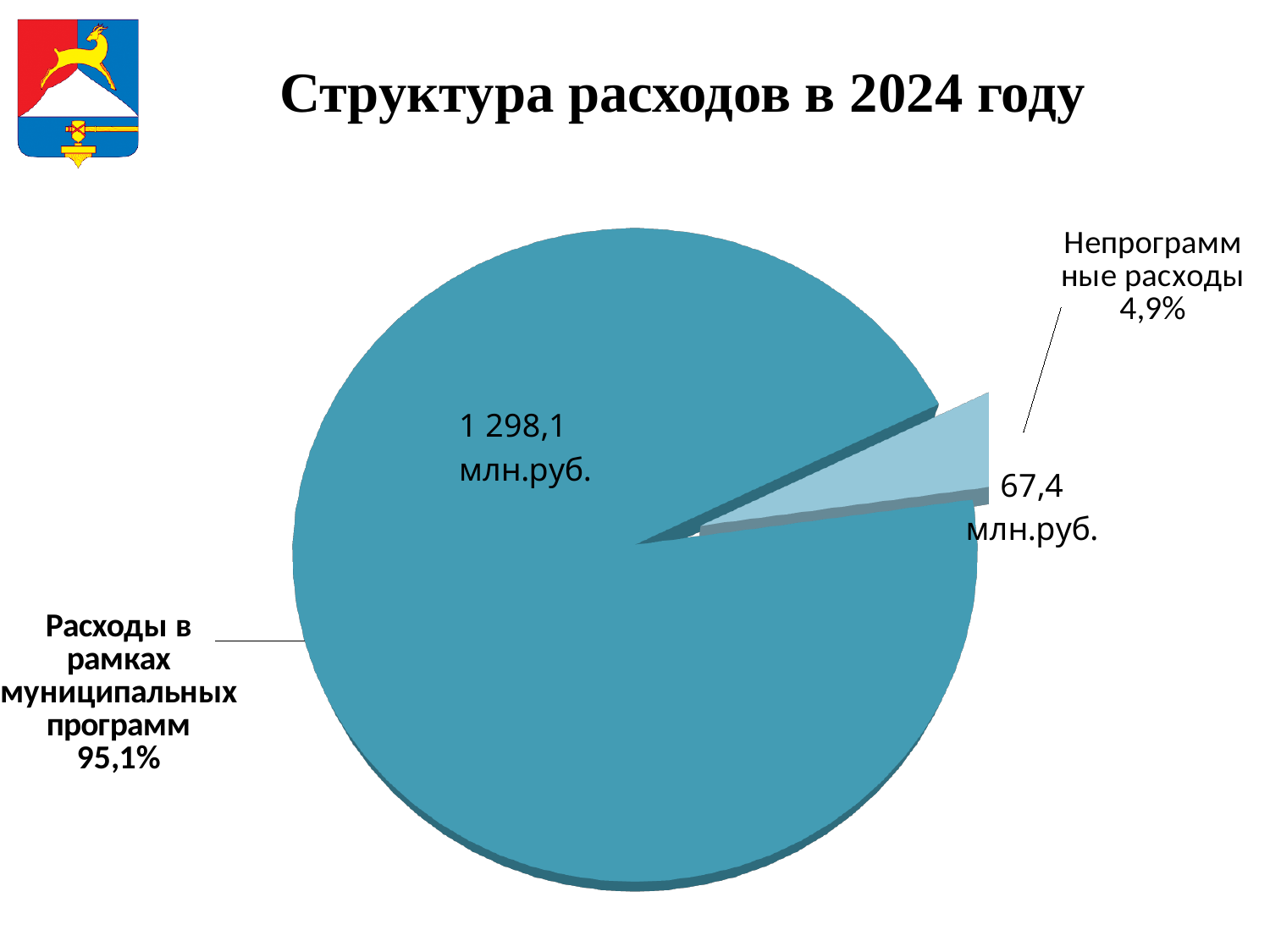
How many slices does the pie chart have? 2 What share of the pie does 'Расходы в рамках муниципальных программ' take? 95,1% What is the value shown for the slice 'Непрограммные расходы'? 67,4 млн.руб. Which slice of the pie is the largest? Расходы в рамках муниципальных программ Which is larger: 'Расходы в рамках муниципальных программ' or 'Непрограммные расходы'? Расходы в рамках муниципальных программ What is the title of the chart on the slide? Структура расходов в 2024 году What kind of chart is shown on the slide? Pie chart What is the difference in млн.руб. between 'Расходы в рамках муниципальных программ' and 'Непрограммные расходы'? 1 230,7 млн.руб. What share of the pie does 'Непрограммные расходы' take? 4,9% Which slice of the pie is the smallest? Непрограммные расходы What is the total of the two slices in млн.руб.? 1 365,5 млн.руб. What is the value shown for the slice 'Расходы в рамках муниципальных программ'? 1 298,1 млн.руб.